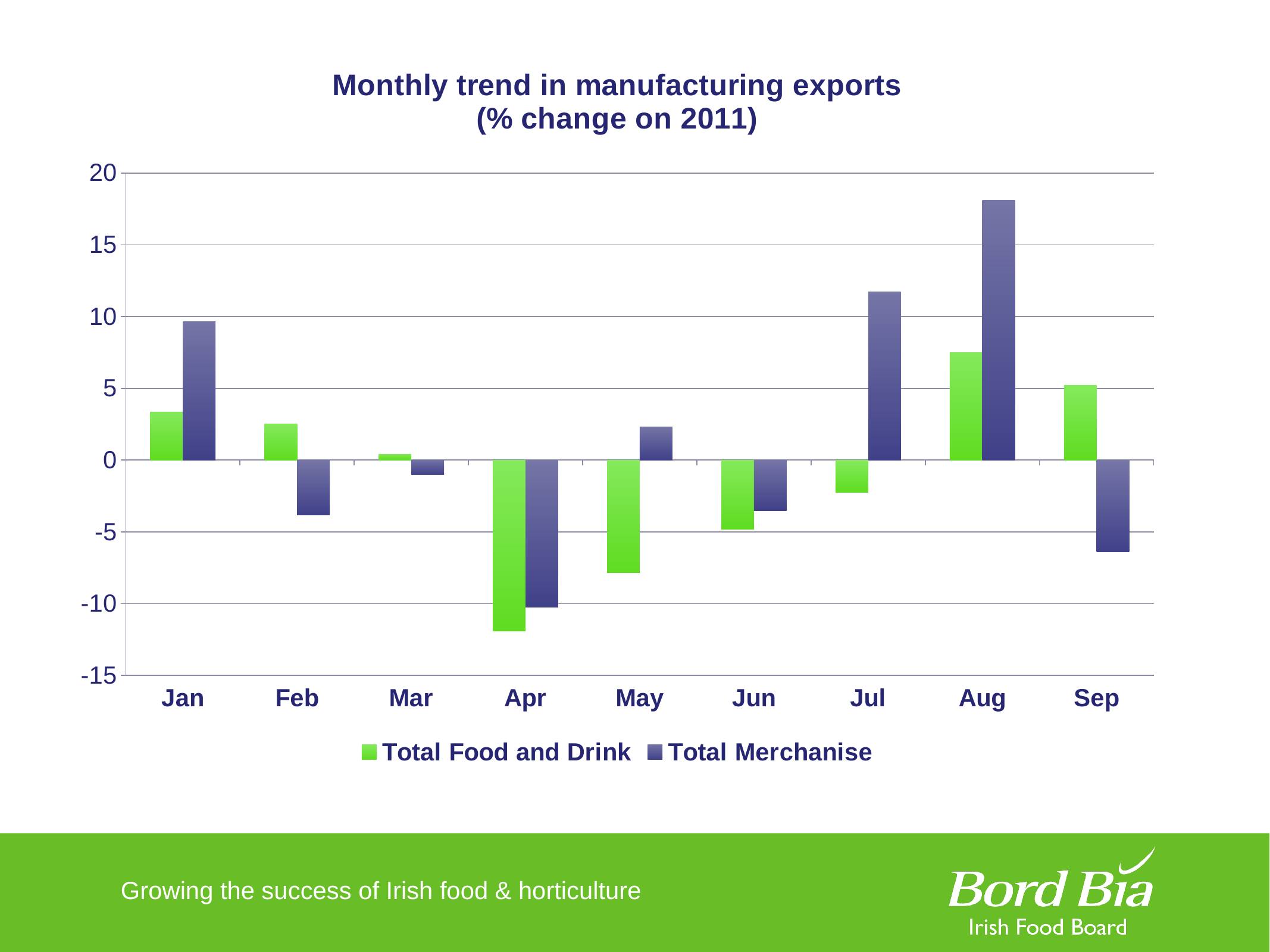
How many series does the legend list? 2 Is the Total Merchanise value for Jul greater or less than 10? greater In which month is the Total Merchanise value highest? Aug In which month is the Total Food and Drink value lowest? Apr What kind of chart is shown on the slide? bar chart Is the Total Merchanise value for Aug greater or less than 15? greater What colour represents Total Food and Drink in the chart? green Which is larger, the Total Food and Drink value for Jan or for Sep? Sep How many months are shown on the x axis? 9 In which month is the Total Food and Drink value highest? Aug Is the Total Food and Drink value for Apr greater or less than -10? less Which is larger, the Total Merchanise value for Jul or for Aug? Aug